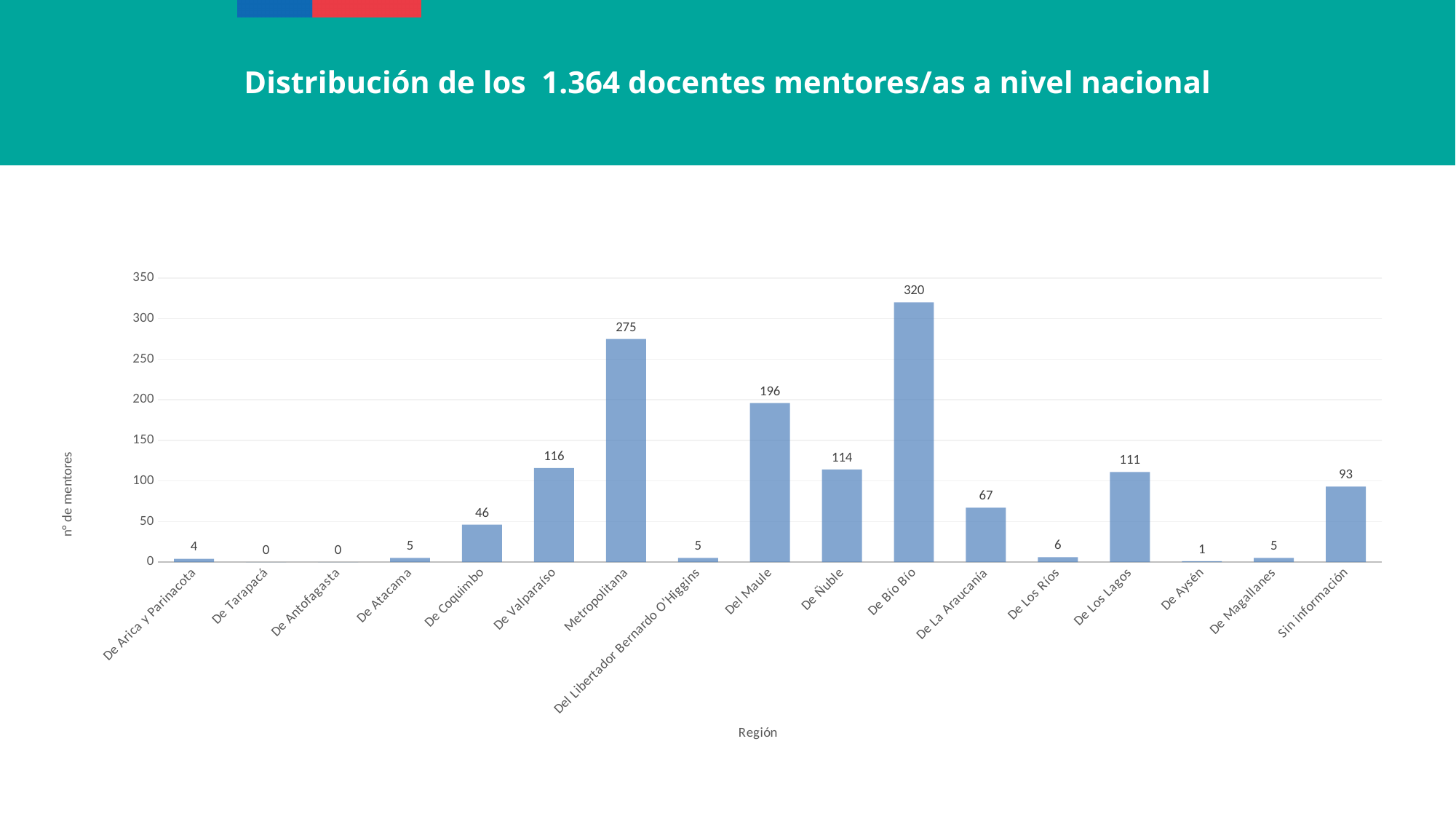
What is the difference between De Bío Bío and Metropolitana? 45 Which region has the highest number of mentors? De Bío Bío What is the label of the y axis? n° de mentores What is the difference between Del Maule and De Ñuble? 82 Is the value for Del Maule greater or less than 150? greater How many mentors are shown for the Metropolitana region? 275 Which has more mentors, De Los Lagos or De La Araucanía? De Los Lagos How many regions (categories) are shown on the x axis? 17 What kind of chart is shown on the slide? Bar chart What is the value for De Valparaíso? 116 What is the value for Sin información? 93 Which regions have a value of 0? De Tarapacá and De Antofagasta